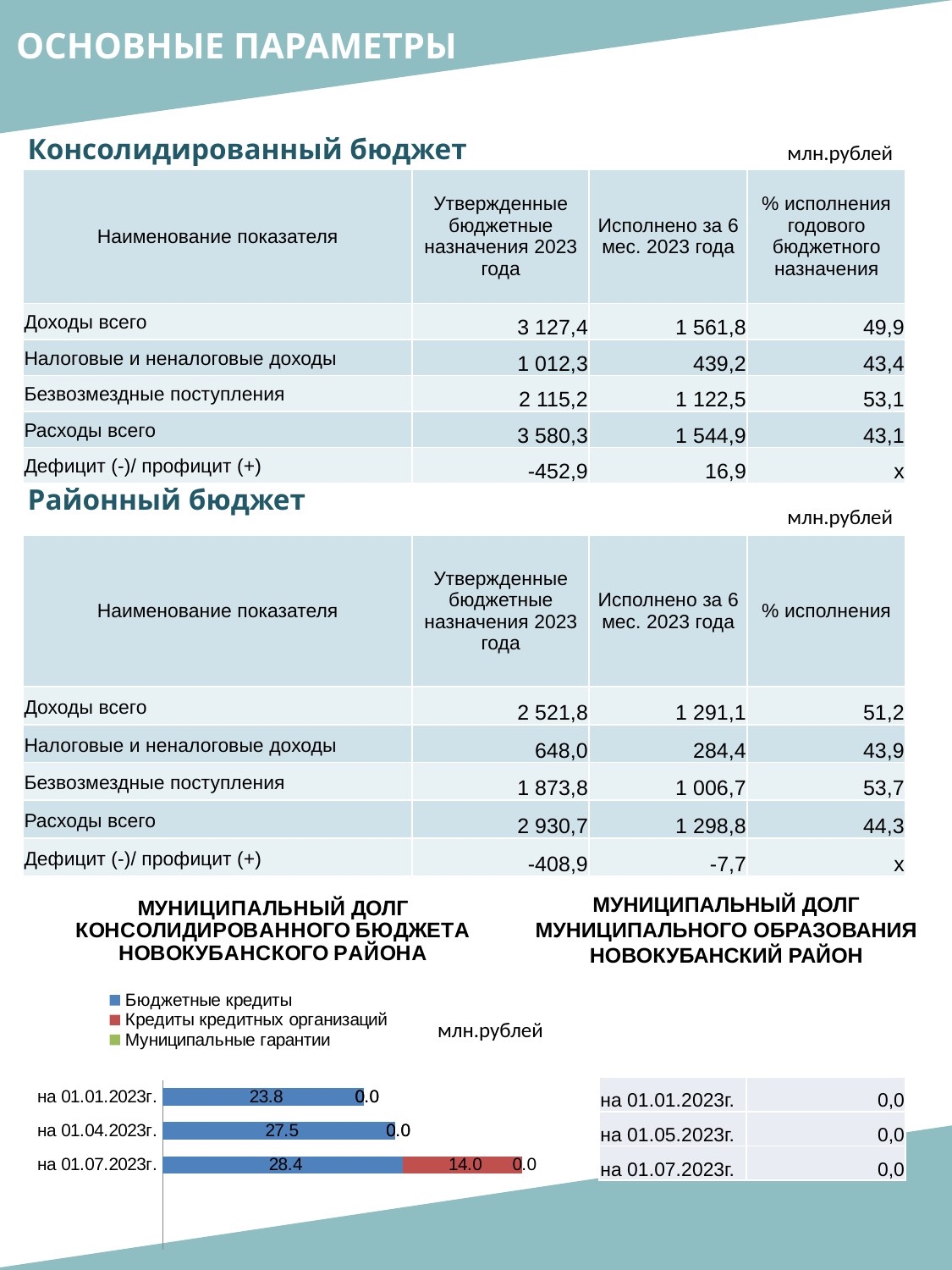
How many dates (categories) are shown on the bar chart? 3 What kind of chart is shown on the slide? bar chart On which date is the value of Бюджетные кредиты the highest? на 01.07.2023г. What is the difference between Бюджетные кредиты on 01.07.2023г. and on 01.01.2023г.? 4.6 Do the values of Бюджетные кредиты rise or fall from 01.01.2023г. to 01.07.2023г.? rise What is the value of Бюджетные кредиты on 01.07.2023г.? 28.4 What is the total of the stacked bar for 01.07.2023г.? 42.4 What is the value of Бюджетные кредиты on 01.04.2023г.? 27.5 What is the value of Бюджетные кредиты on 01.01.2023г.? 23.8 On which date is the value of Бюджетные кредиты the lowest? на 01.01.2023г. What is the value of Кредиты кредитных организаций on 01.07.2023г.? 14.0 How many series does the legend of the bar chart list? 3